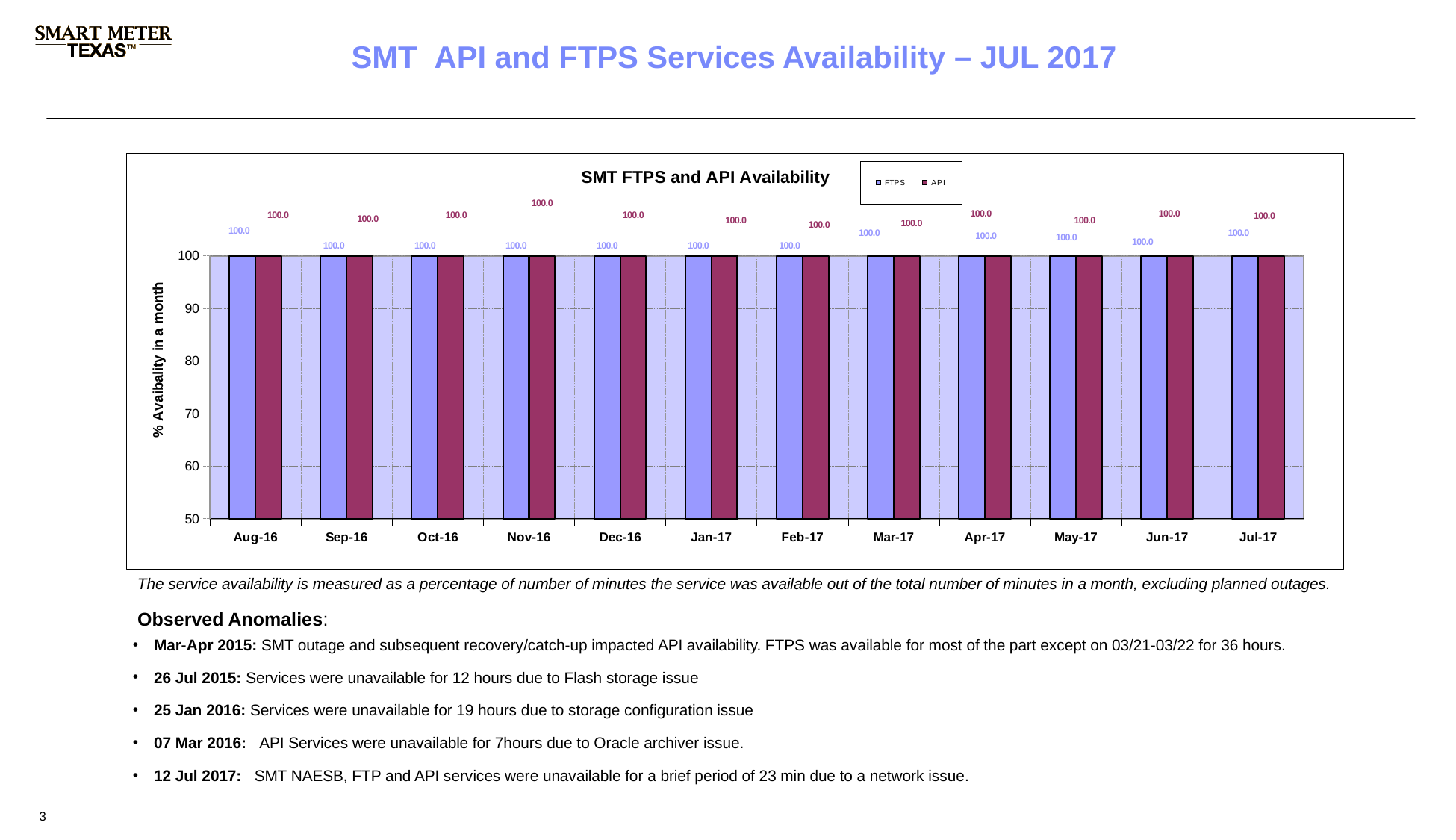
What is the title of the chart? SMT FTPS and API Availability What is the API availability value for Jul-17? 100.0 Do the FTPS availability values rise, fall, or stay flat from Aug-16 to Jul-17? Stay flat What is the difference between the FTPS and API availability values for Mar-17? 0.0 Is the API availability value for Dec-16 greater or less than 90? greater How many series does the chart legend list? 2 What is the FTPS availability value for Jan-17? 100.0 What is the API availability value for Nov-16? 100.0 What is the label of the y axis of the chart? % Avaibality in a month What is the FTPS availability value for Aug-16? 100.0 How many months are shown on the x axis of the chart? 12 What kind of chart is shown on the slide? Bar chart